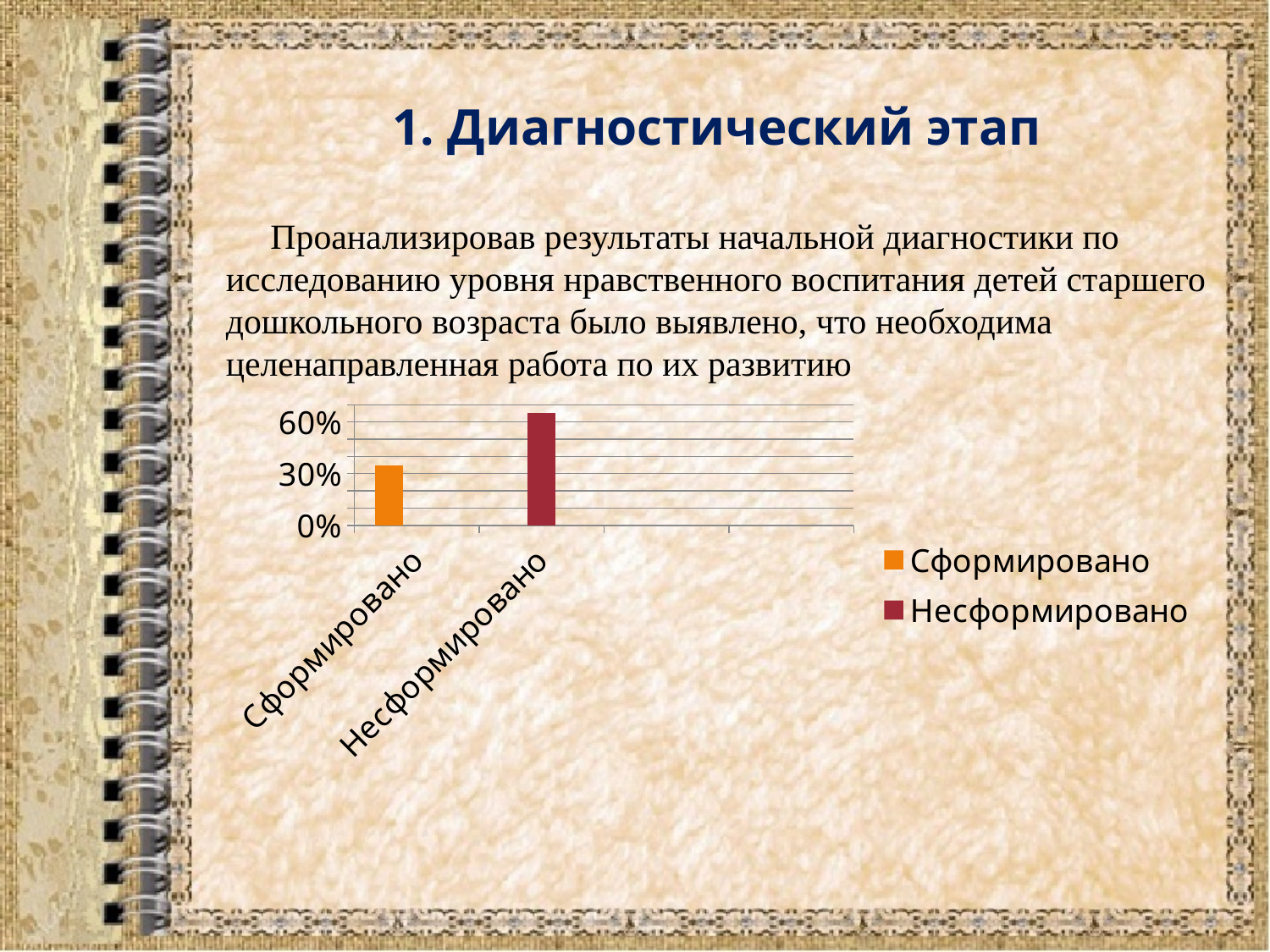
Is the value for Сформировано greater or less than 60%? less What is the second entry listed in the chart legend? Несформировано Is the value for Несформировано greater or less than 30%? greater Which is larger, the value for Сформировано or the value for Несформировано? Несформировано How many bars are plotted in the chart? 2 Which category has the lowest value in the chart? Сформировано What colour is the bar for Сформировано? orange Which category has the highest value in the chart? Несформировано Is the value for Несформировано greater or less than 60%? greater What kind of chart is shown on the slide? bar chart How many series does the chart legend list? 2